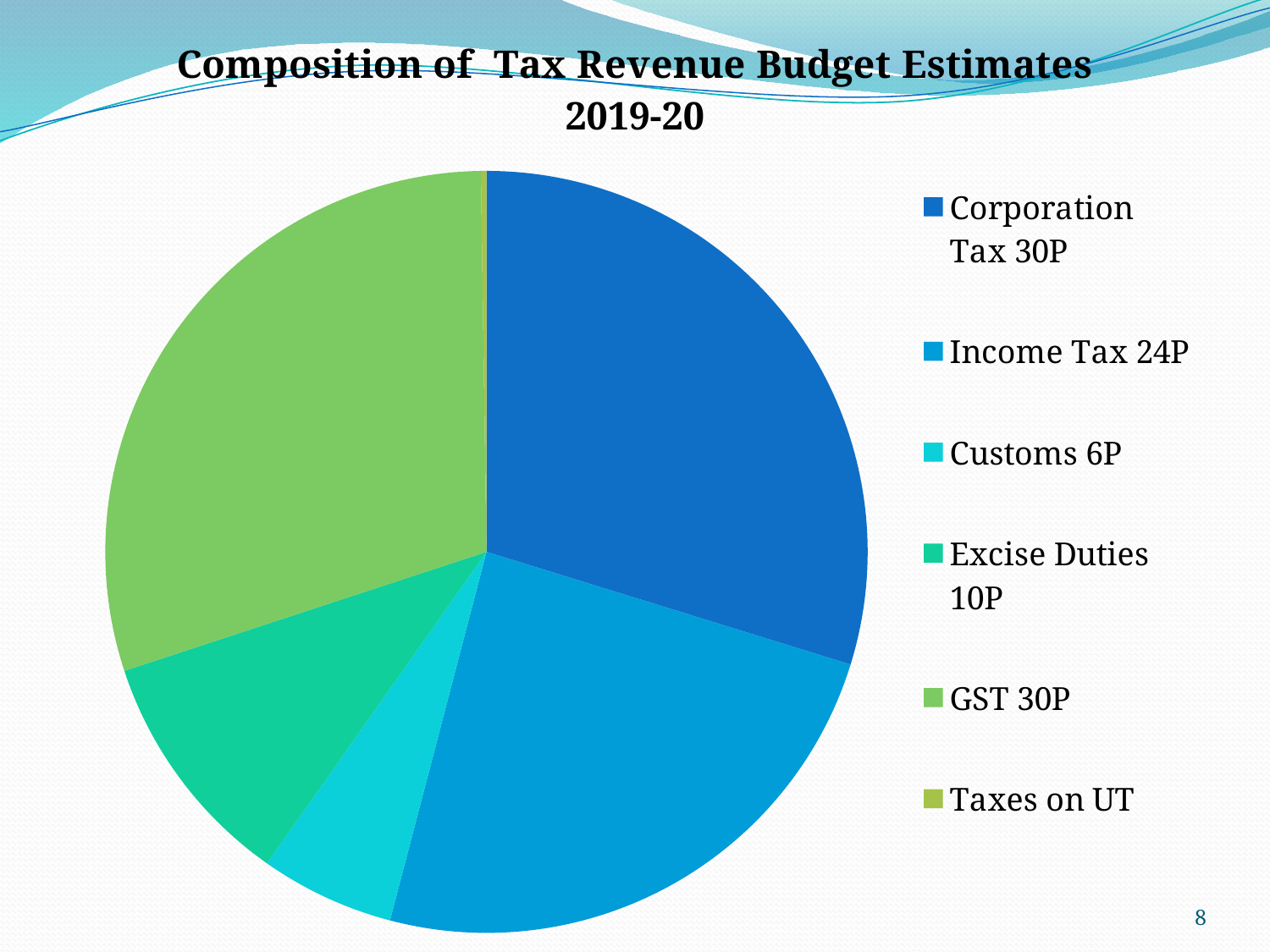
What value is shown for Corporation Tax in the pie chart? 30P Which slice of the pie chart is the smallest? Taxes on UT What value is shown for GST in the pie chart? 30P What value is shown for Excise Duties in the pie chart? 10P How many categories does the pie chart legend list? 6 What value is shown for Income Tax in the pie chart? 24P What is the title of the chart on the slide? Composition of Tax Revenue Budget Estimates 2019-20 What is the difference between the Excise Duties value and the Customs value? 4P What kind of chart is shown on the slide? Pie chart Which is larger, Income Tax or Excise Duties? Income Tax What value is shown for Customs in the pie chart? 6P What is the difference between the Corporation Tax value and the Income Tax value? 6P